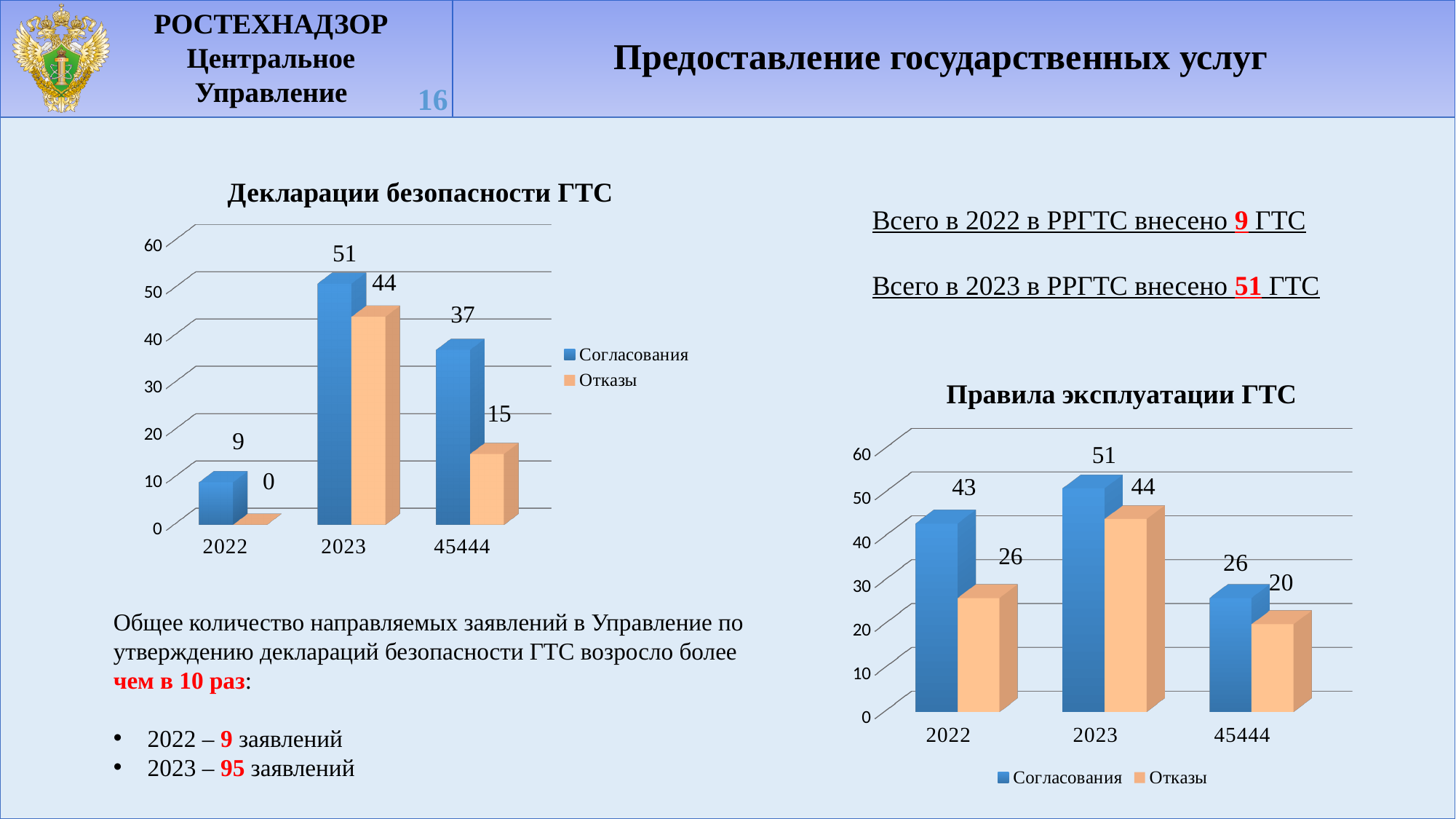
In the chart "Правила эксплуатации ГТС", what is the difference between Согласования and Отказы for 2022? 17 What type of chart is "Правила эксплуатации ГТС"? bar chart In the chart "Декларации безопасности ГТС", which category has the lowest value of Согласования? 2022 In the chart "Декларации безопасности ГТС", what is the difference between Согласования and Отказы for the category 45444? 22 In the chart "Декларации безопасности ГТС", how many series does the legend list? 2 In the chart "Правила эксплуатации ГТС", is the value of Отказы for 2022 larger or smaller than the value of Отказы for 45444? larger In the chart "Правила эксплуатации ГТС", what is the value of Согласования for 2022? 43 In the chart "Правила эксплуатации ГТС", what is the value of Отказы for 2023? 44 In the chart "Декларации безопасности ГТС", what is the value of Отказы for 2022? 0 In the chart "Правила эксплуатации ГТС", how many categories are shown on the x axis? 3 In the chart "Декларации безопасности ГТС", what is the value of Согласования for 2023? 51 In the chart "Правила эксплуатации ГТС", which category has the highest value of Согласования? 2023